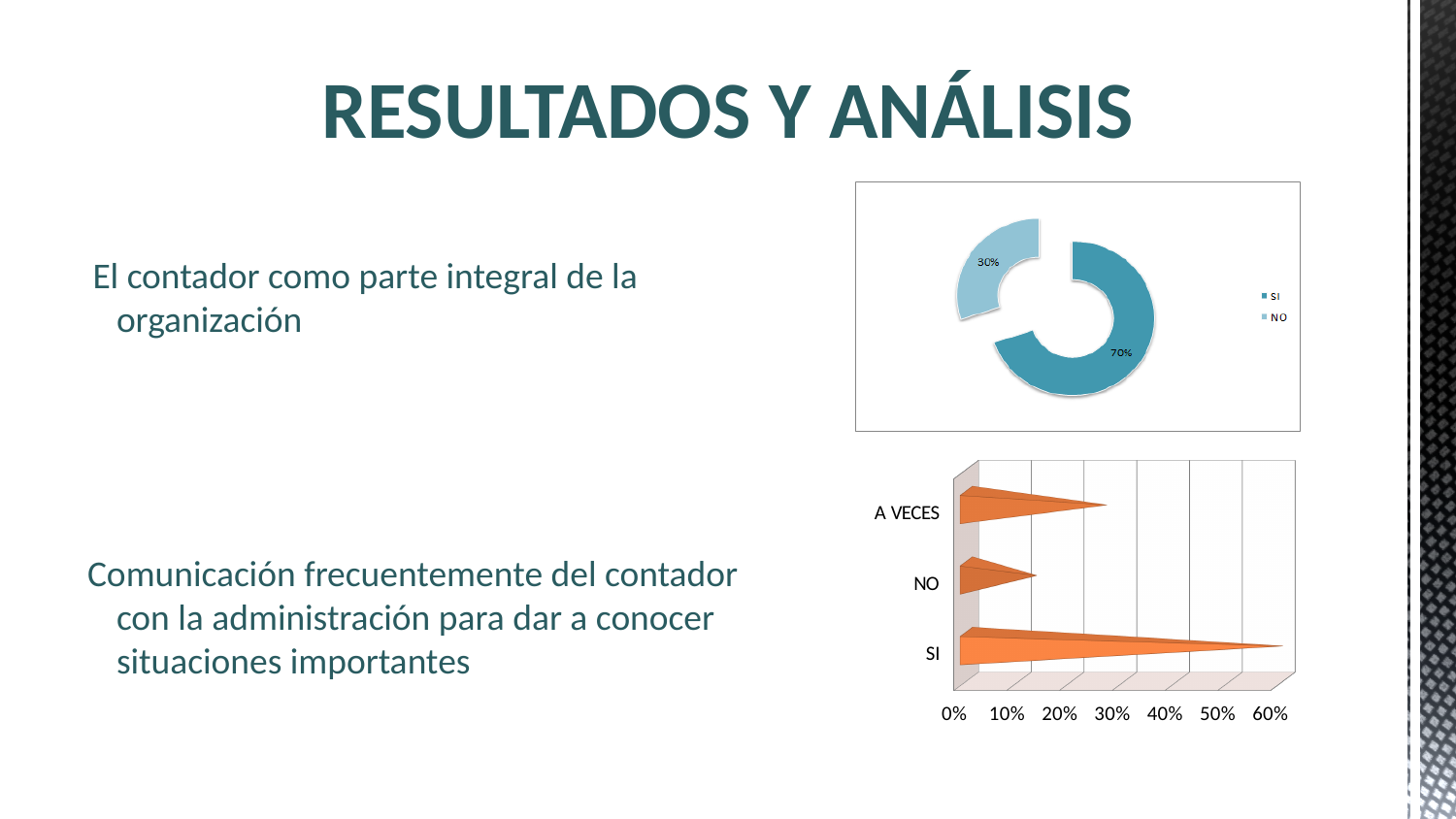
In the bottom-right bar chart, is the value for NO greater or less than 20%? less In the bottom-right bar chart, which category has the lowest value? NO In the bottom-right bar chart, is the value for SI greater or less than 50%? greater What kind of chart is the top-right chart? Doughnut chart In the bottom-right bar chart, how many categories are shown? 3 What kind of chart is the bottom-right chart? Bar chart In the top-right doughnut chart, what is the difference between the SI and NO shares? 40% In the bottom-right bar chart, which category has the highest value? SI In the top-right doughnut chart, what percentage is shown for NO? 30% In the top-right doughnut chart, which category has the larger share? SI In the top-right doughnut chart, what percentage is shown for SI? 70% In the top-right doughnut chart, how many categories are shown? 2